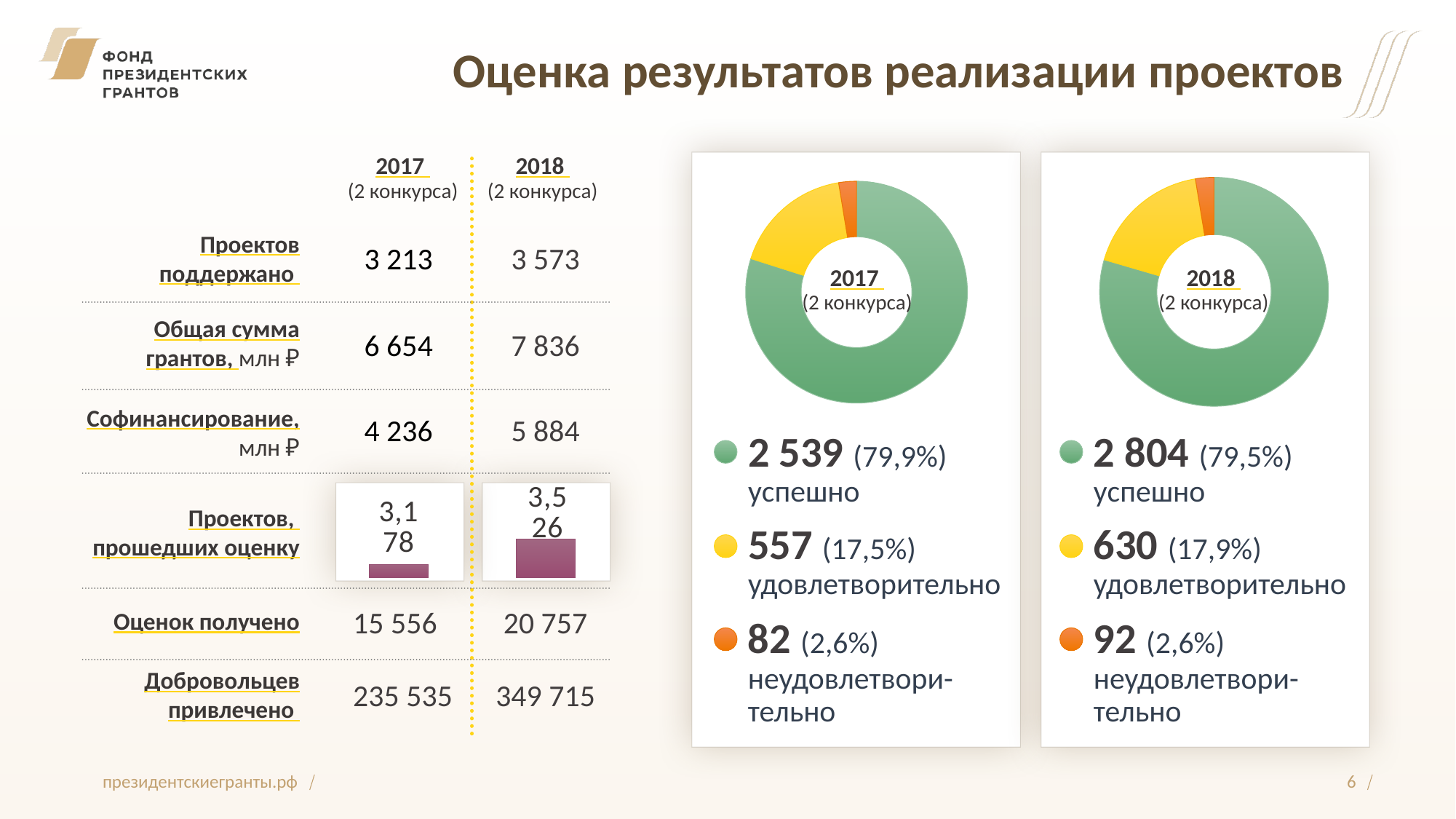
How many categories does each donut chart on the right show? 3 In the 2017 donut chart, what is the value for the 'успешно' segment? 2 539 In the 2018 donut chart, what is the value for the 'удовлетворительно' segment? 630 In the 2017 donut chart, what share of the total does the 'неудовлетворительно' segment represent? 2,6% In the 2018 donut chart, which category has the largest value? успешно What label is shown in the centre of the left donut chart? 2017 (2 конкурса) What type of chart is used for the 2017 and 2018 evaluation results on the right side of the slide? Donut (pie) chart In the 2017 donut chart, which category has the smallest value? неудовлетворительно In the 2018 donut chart, what colour represents the 'неудовлетворительно' segment? Orange In the 2018 donut chart, what share of the total does the 'успешно' segment represent? 79,5% Which is larger: the 'удовлетворительно' value in the 2017 donut chart or in the 2018 donut chart? 2018 What is the difference between the 'успешно' value in the 2018 donut chart and the 'успешно' value in the 2017 donut chart? 265